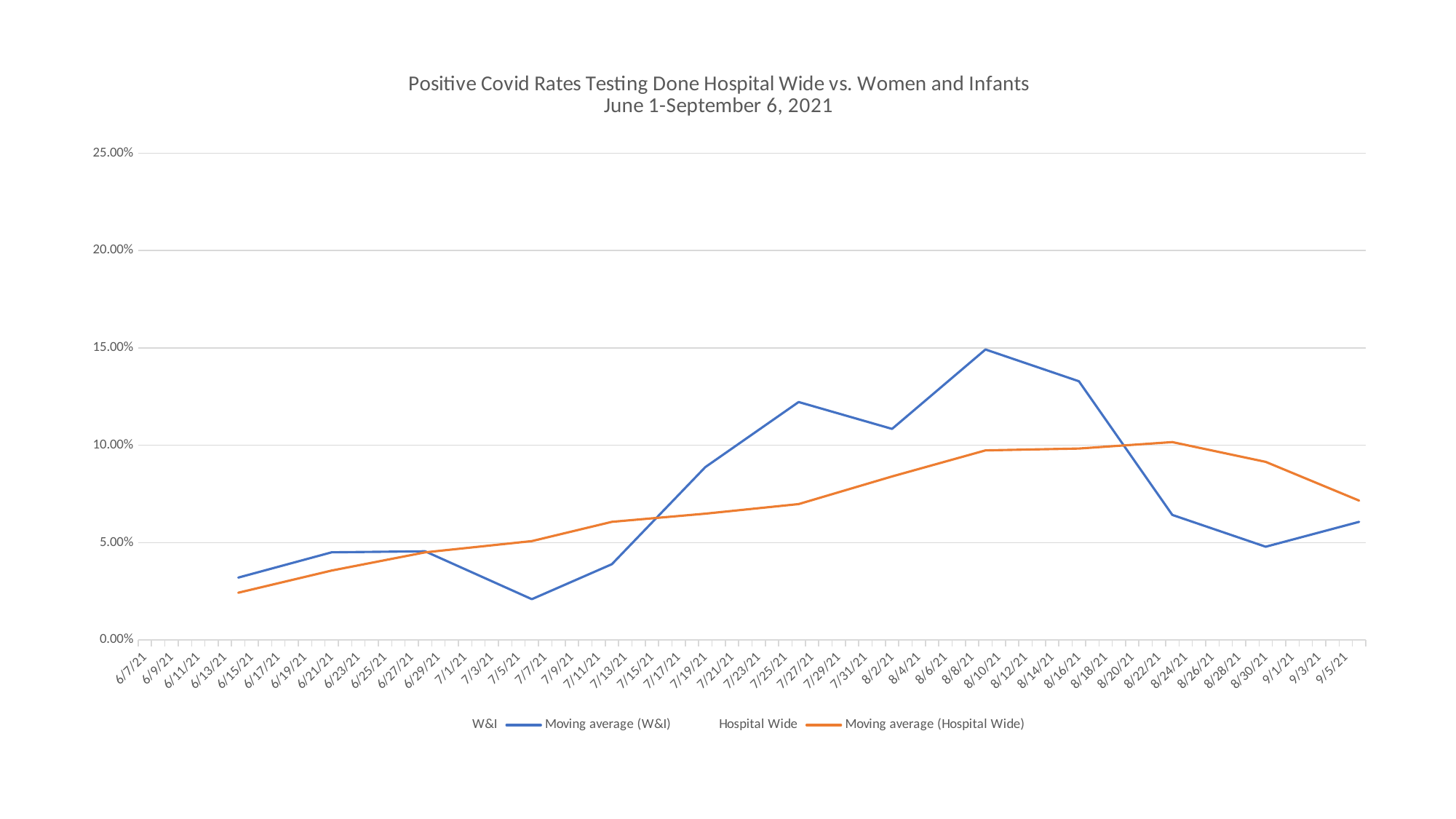
At 8/30/21, which line is higher: Moving average (W&I) or Moving average (Hospital Wide)? Moving average (Hospital Wide) How many series does the legend list? 4 Is the Moving average (Hospital Wide) value at 9/5/21 greater or less than 5.00%? greater On which date does the Moving average (W&I) line reach its highest value? 8/10/21 Which colour is used for the Moving average (Hospital Wide) line? orange What kind of chart is shown on the slide? line chart At 8/10/21, which line is higher: Moving average (W&I) or Moving average (Hospital Wide)? Moving average (W&I) Is the Moving average (W&I) value at 7/27/21 greater or less than 10.00%? greater Is the Moving average (W&I) value at 7/7/21 greater or less than 5.00%? less What is the title of the chart? Positive Covid Rates Testing Done Hospital Wide vs. Women and Infants June 1-September 6, 2021 Does the Moving average (W&I) line rise or fall between 8/10/21 and 8/30/21? fall On which date does the Moving average (W&I) line reach its lowest value? 7/7/21